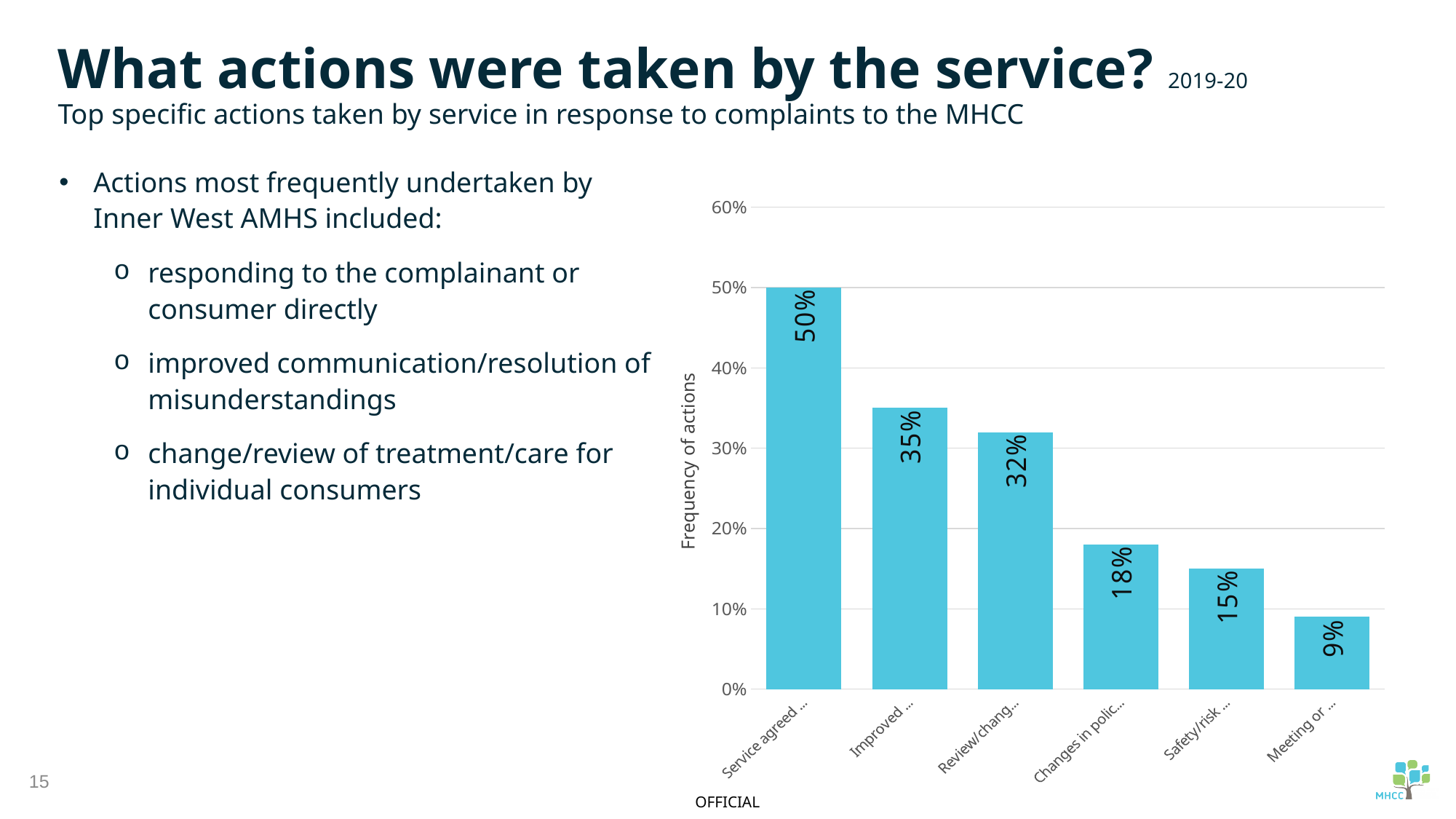
What type of chart is shown on the slide? bar chart Which is larger, the value for "Changes in polic..." or the value for "Safety/risk ..."? Changes in polic... What is the value of the bar labelled "Changes in polic..."? 18% Do the bar values rise or fall from left to right across the chart? fall What is the value of the last (rightmost) bar, labelled "Meeting or ..."? 9% Which bar has the lowest value? Meeting or ... What is the label on the vertical axis of the chart? Frequency of actions How many bars are plotted in the chart? 6 What is the difference between the "Improved ..." bar and the "Review/chang..." bar? 3% Which bar has the highest value? Service agreed ... What is the value of the first (leftmost) bar, labelled "Service agreed ..."? 50% What is the value of the bar labelled "Safety/risk ..."? 15%